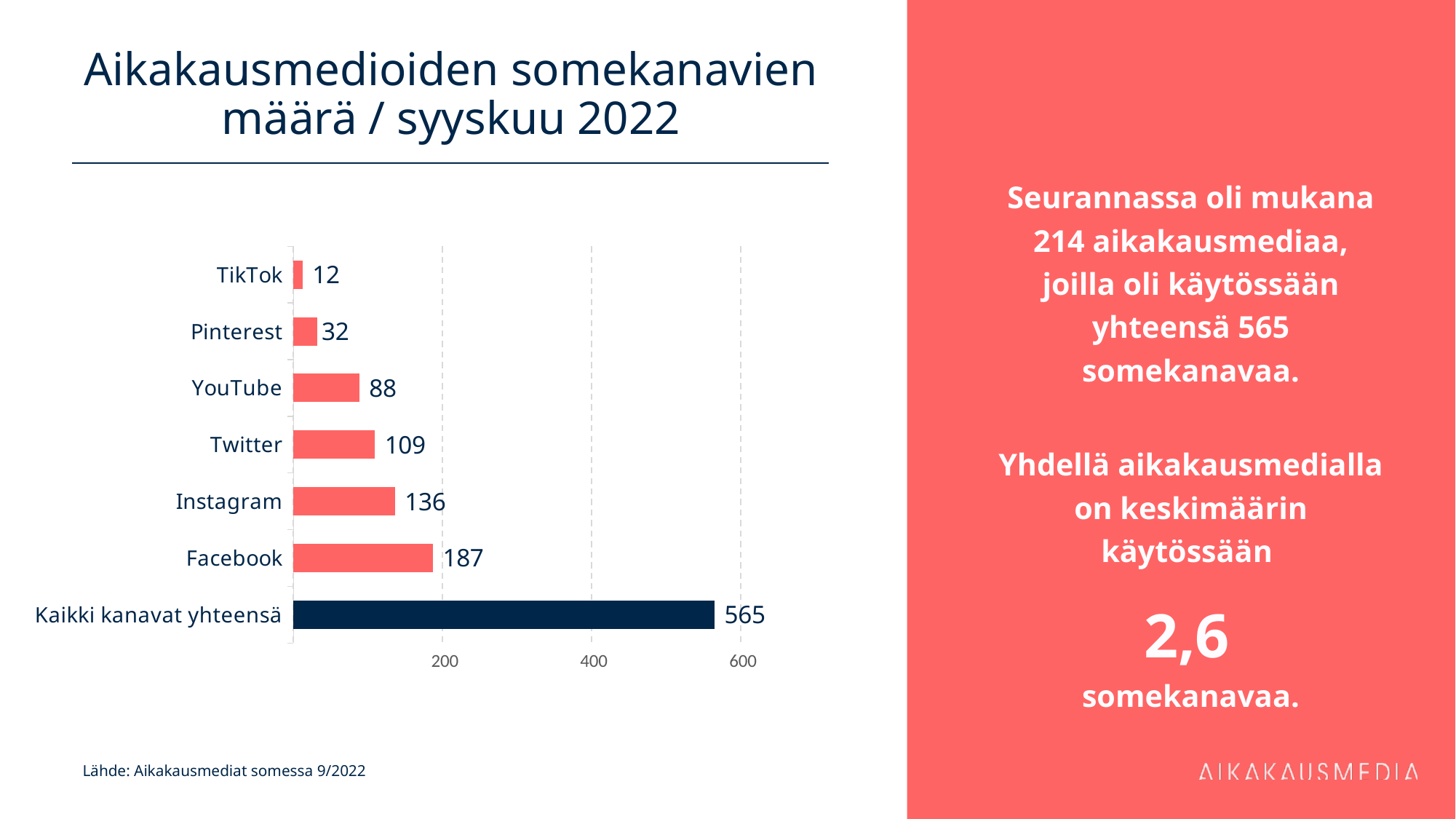
Which category has the lowest value? TikTok Which is larger, the value for Pinterest or the value for YouTube? YouTube What is the value for TikTok? 12 What is the difference between the values for Facebook and Instagram? 51 What is the value shown for Kaikki kanavat yhteensä? 565 What is the difference between the values for Twitter and YouTube? 21 What is the value for Instagram? 136 How many categories (bars) does the chart show? 7 What kind of chart is shown on the slide? Bar chart What is the value for Facebook? 187 What is the title of the chart on the slide? Aikakausmedioiden somekanavien määrä / syyskuu 2022 Which individual channel (excluding the total bar) has the highest value? Facebook